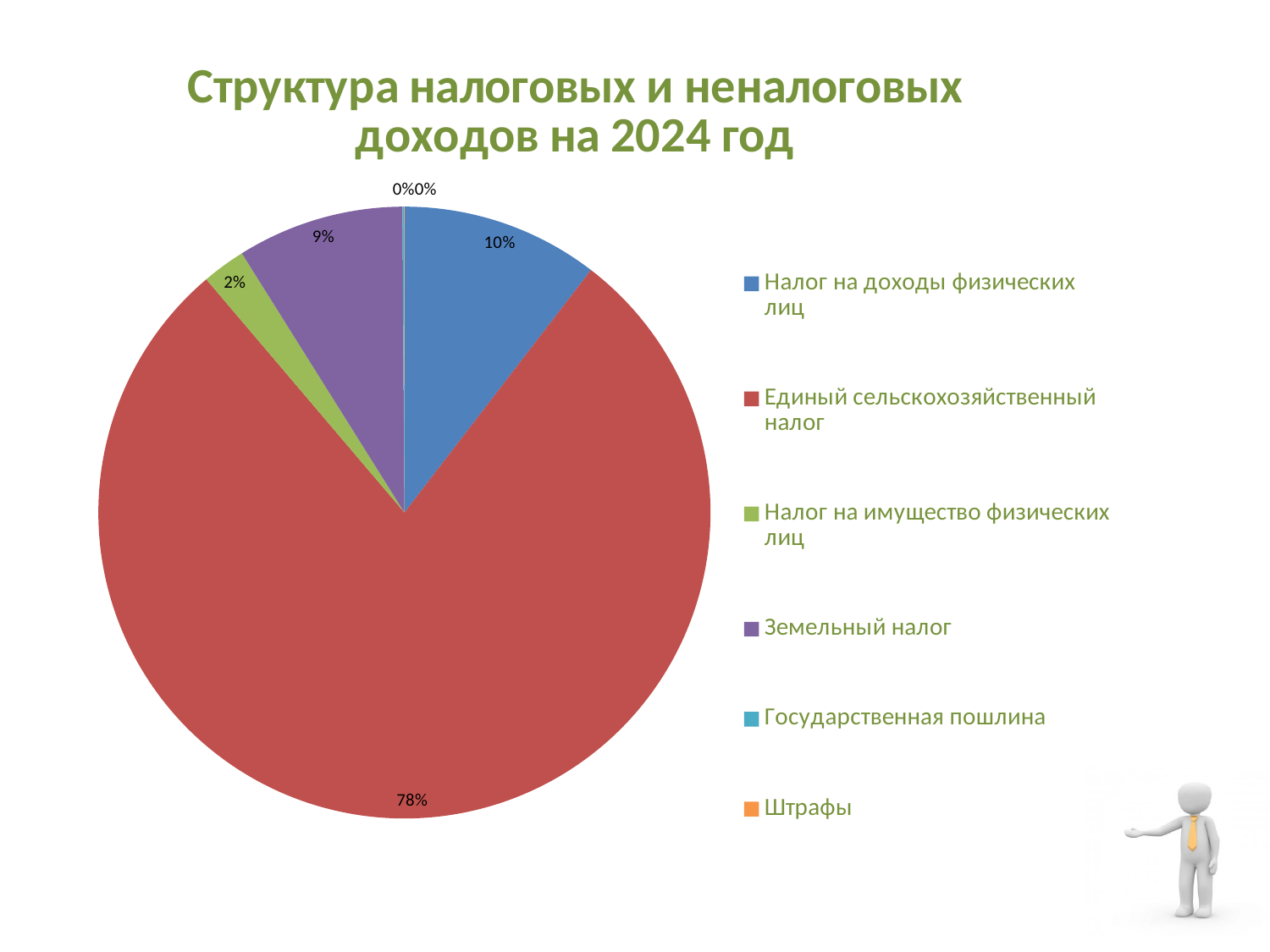
What share of the pie is Земельный налог? 9% What is the difference between the share for Единый сельскохозяйственный налог and the share for Налог на доходы физических лиц? 68% How many entries does the legend list? 6 What share of the pie is Единый сельскохозяйственный налог? 78% What share of the pie is Государственная пошлина? 0% What is the title of the chart? Структура налоговых и неналоговых доходов на 2024 год What colour is the slice for Единый сельскохозяйственный налог? Red What kind of chart is shown on the slide? Pie chart Which category has the largest share of the pie? Единый сельскохозяйственный налог Which is larger, the share for Налог на доходы физических лиц or the share for Земельный налог? Налог на доходы физических лиц